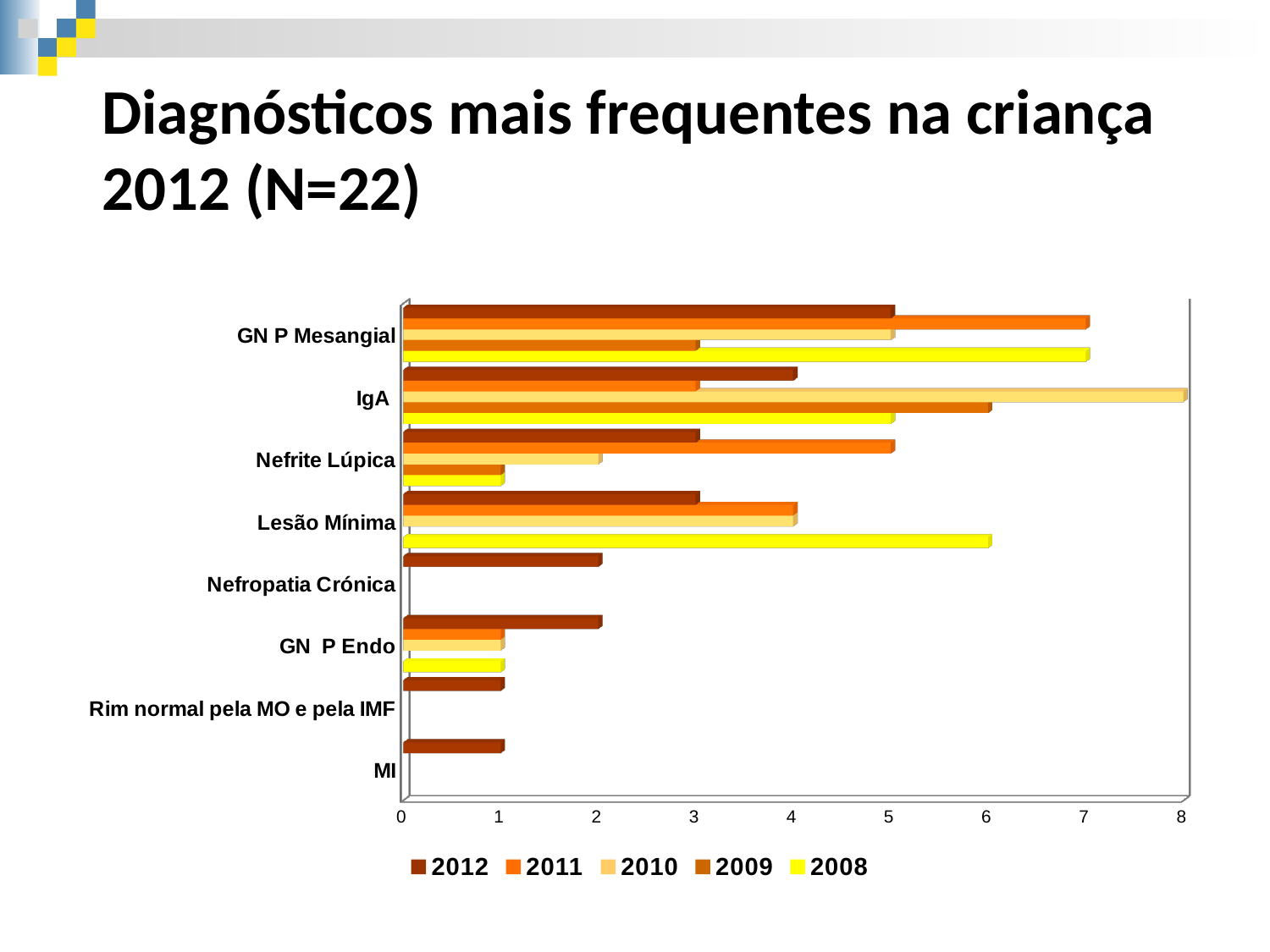
What is the difference between the 2011 and 2012 values for GN P Mesangial? 2 Which category has the highest value for 2012? GN P Mesangial How many series does the legend list? 5 What is the value for GN P Mesangial in 2012? 5 Which is larger for 2012: IgA or Nefrite Lúpica? IgA Which year is listed first in the legend? 2012 What is the value for GN P Mesangial in 2011? 7 What is the value for IgA in 2010? 8 What kind of chart is shown on the slide? bar chart What is the value for Lesão Mínima in 2008? 6 How many diagnosis categories are shown on the y axis? 8 Is the value for GN P Mesangial in 2008 greater or less than 6? greater